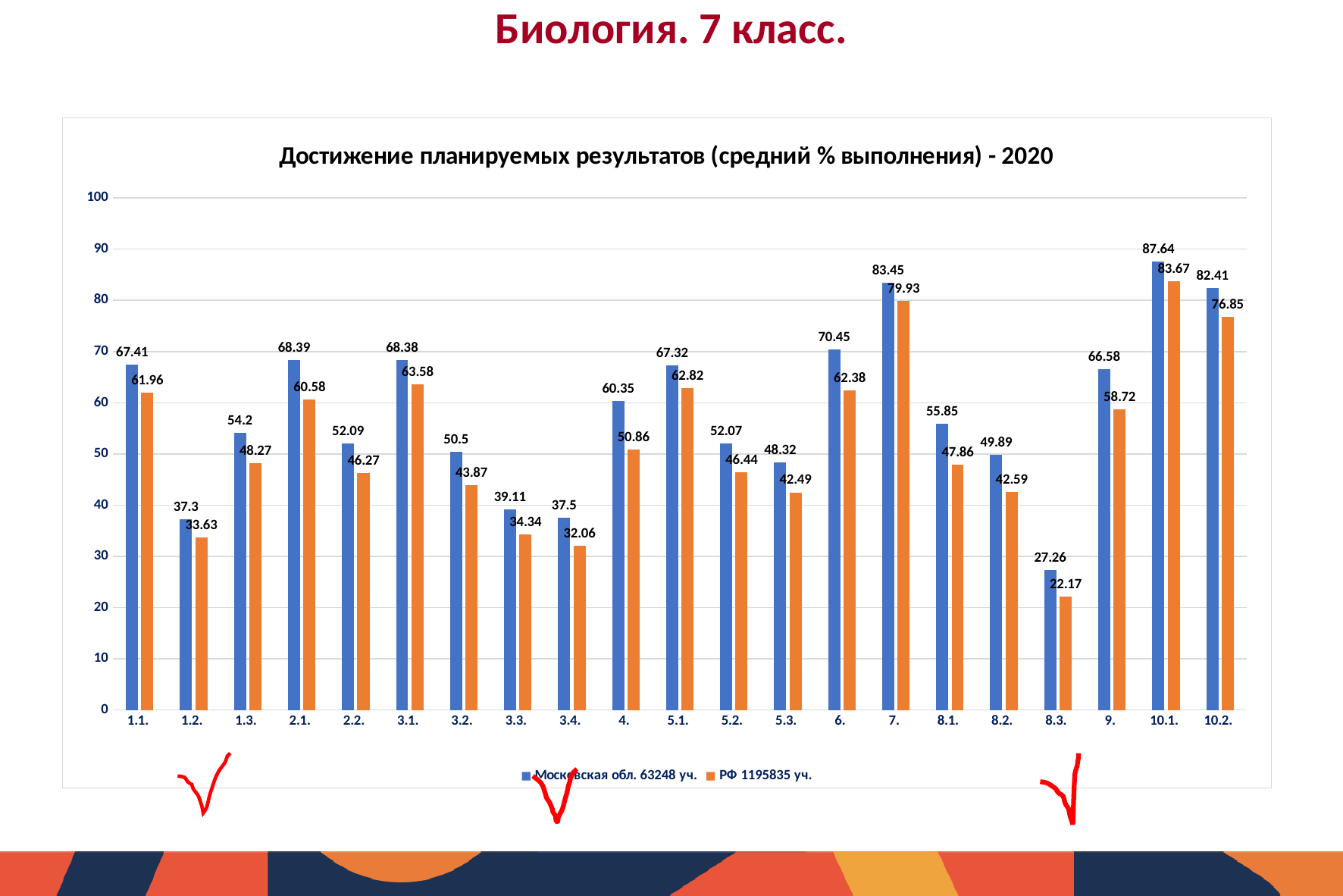
What is the difference between Московская обл. and РФ for task 10.1.? 3.97 Is the value for Московская обл. for task 1.2. greater or less than 40? less Which task has the highest value for Московская обл.? 10.1. Which is larger: the РФ value for task 7. or the РФ value for task 10.2.? task 7. How many tasks (categories) are shown on the x axis? 21 What is the difference between Московская обл. and РФ for task 4.? 9.49 What type of chart is shown on the slide? bar chart How many series does the legend list? 2 What is the value for РФ for task 8.3.? 22.17 What is the value for Московская обл. for task 1.1.? 67.41 Which task has the lowest value for РФ? 8.3. What is the value for Московская обл. for task 6.? 70.45